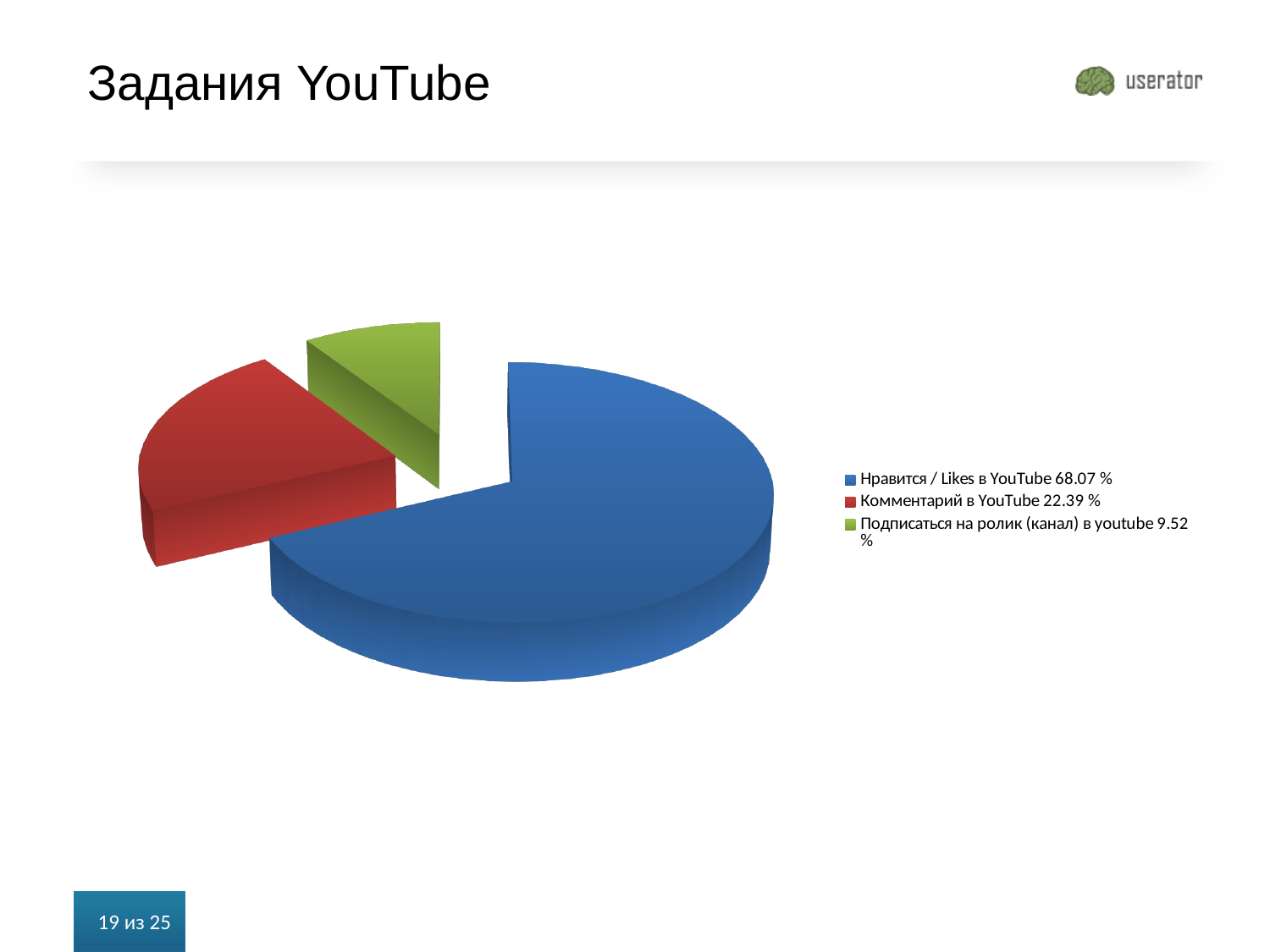
Which is larger: the share for "Комментарий в YouTube" or for "Подписаться на ролик (канал) в youtube"? Комментарий в YouTube What is the difference in percentage points between "Комментарий в YouTube" and "Подписаться на ролик (канал) в youtube"? 12.87 What share of the pie does "Нравится / Likes в YouTube" have? 68.07 % Which category has the largest slice of the pie? Нравится / Likes в YouTube What share of the pie does "Комментарий в YouTube" have? 22.39 % What share of the pie does "Подписаться на ролик (канал) в youtube" have? 9.52 % Which category has the smallest slice of the pie? Подписаться на ролик (канал) в youtube What kind of chart is shown on the slide? pie chart What is the title of the slide containing the pie chart? Задания YouTube How many slices does the pie chart have? 3 What is the difference in percentage points between "Нравится / Likes в YouTube" and "Комментарий в YouTube"? 45.68 What colour is the slice for "Комментарий в YouTube"? red